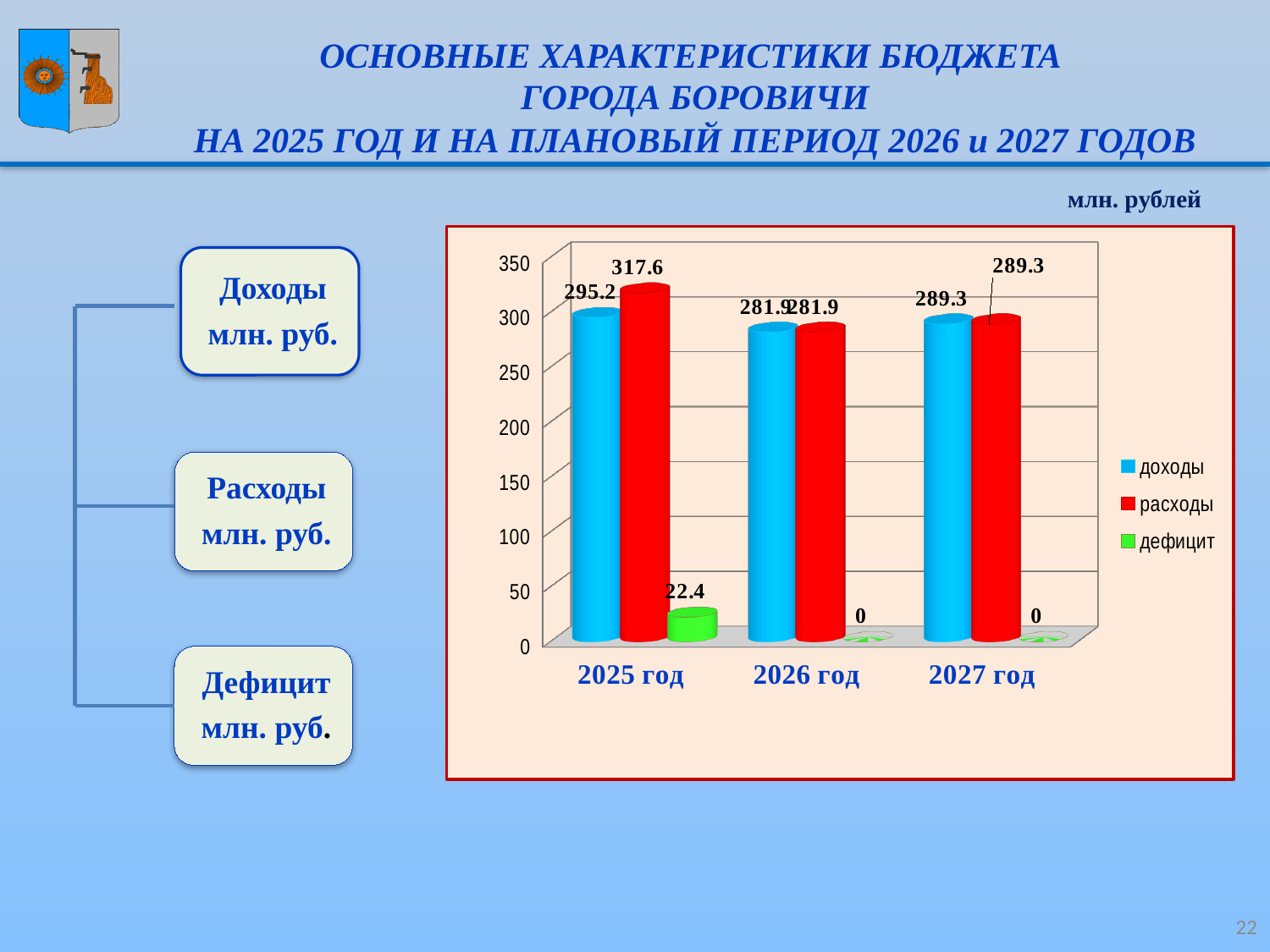
What is the value of доходы for 2025 год? 295.2 What is the value of дефицит for 2026 год? 0 What is the value of расходы for 2027 год? 289.3 In which year is расходы the highest? 2025 год What is the value of расходы for 2025 год? 317.6 What kind of chart is shown on the slide? bar chart How many series does the legend list? 3 In which year is доходы the lowest? 2026 год How many years are shown on the x axis? 3 What is the difference between расходы and доходы for 2025 год? 22.4 What is the value of дефицит for 2025 год? 22.4 Which is larger for 2025 год: доходы or расходы? расходы